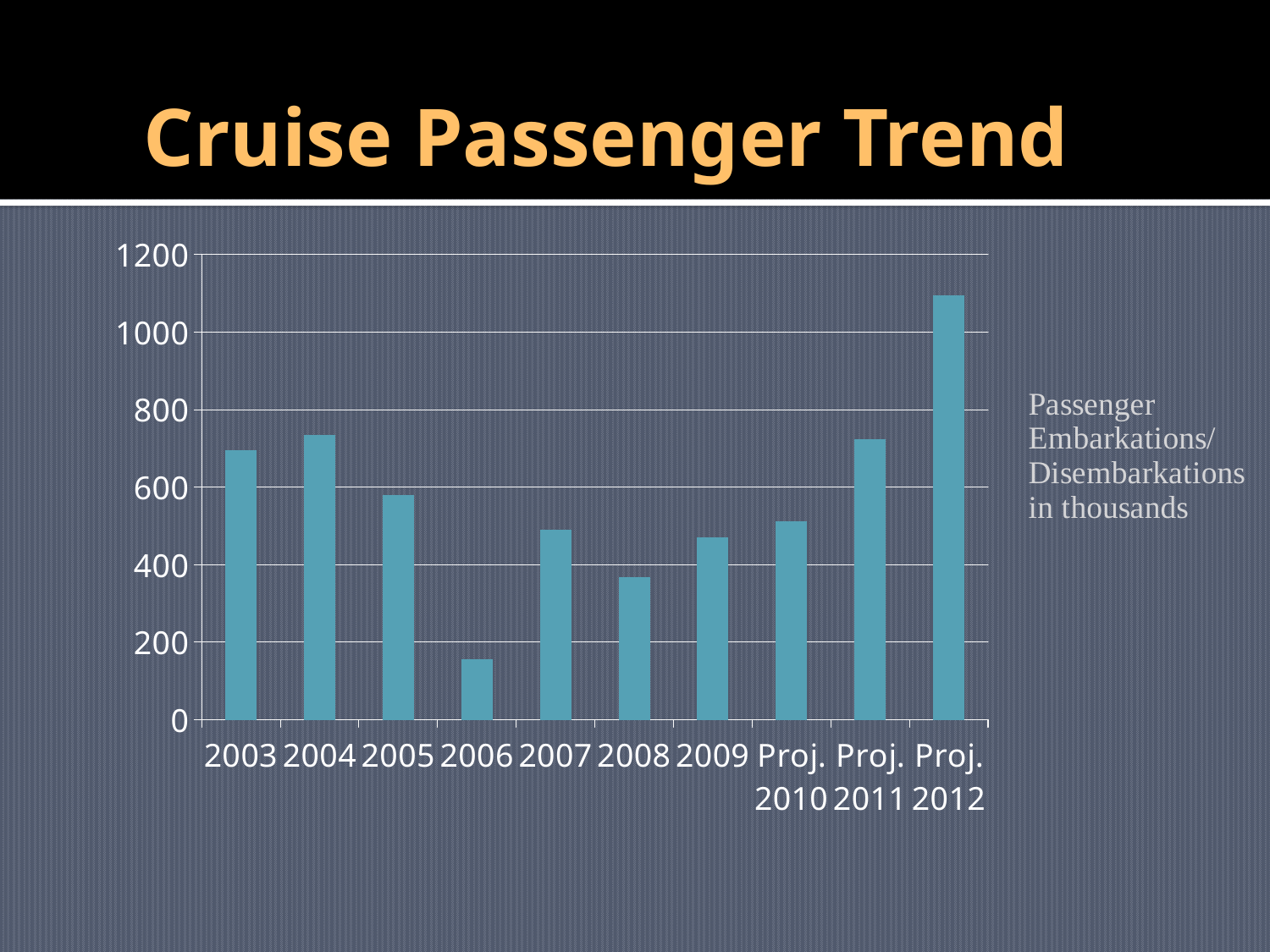
Is the value for 2008 greater or less than 400? less Is the value for Proj. 2012 greater or less than 1000? greater Which is larger, the value for 2004 or the value for 2005? 2004 Is the value for 2006 greater or less than 200? less Do the values rise or fall from 2004 to 2006? fall How many bars (categories) are plotted in the chart? 10 Which category has the lowest bar? 2006 What is the title of the slide? Cruise Passenger Trend Which is larger, the value for 2008 or the value for Proj. 2010? Proj. 2010 What kind of chart is shown on the slide? bar chart Which category has the highest bar? Proj. 2012